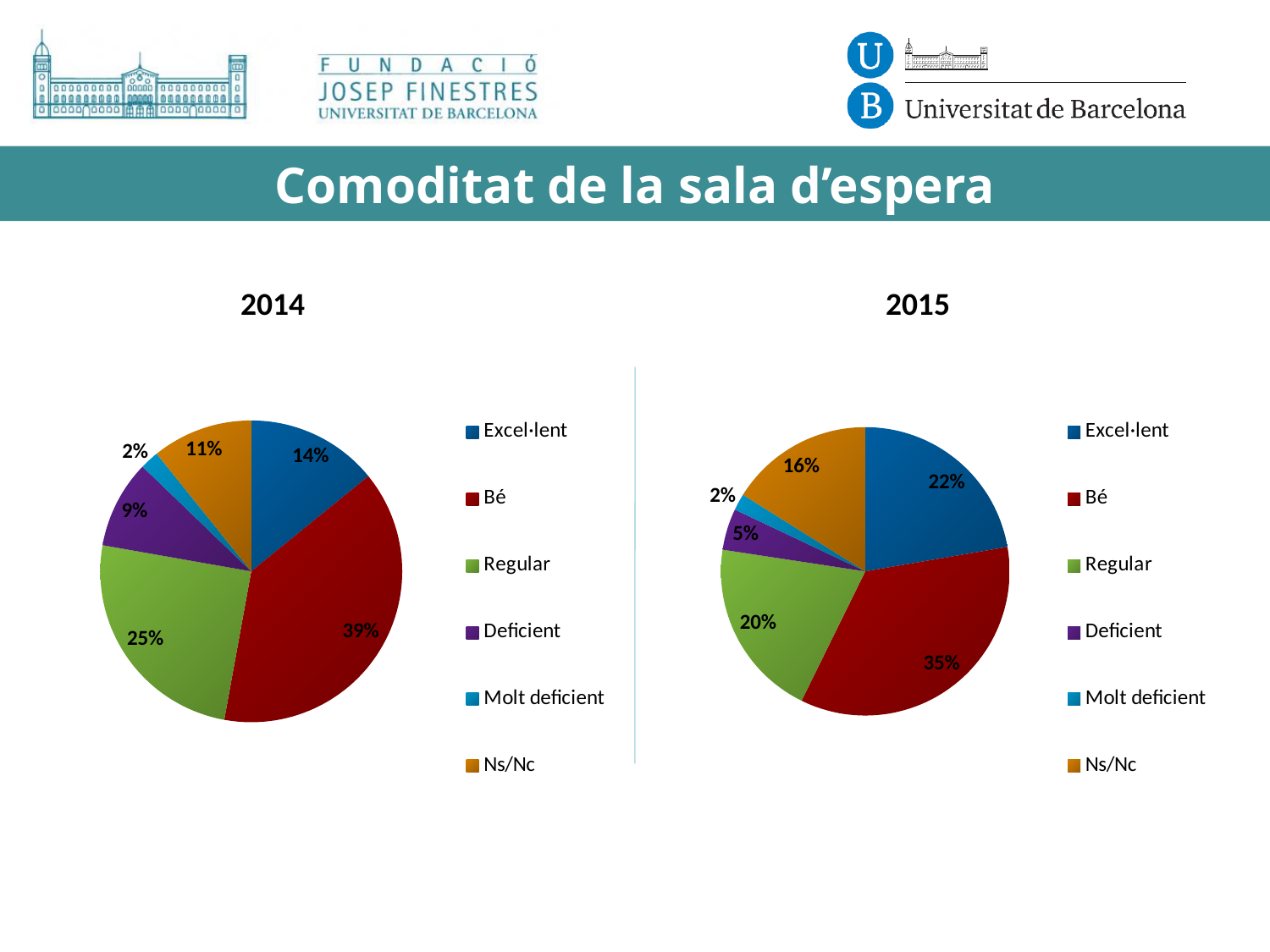
In the 2015 pie chart, which category has the smallest slice? Molt deficient In the 2014 pie chart, what colour is the Regular slice? Green In the 2015 pie chart, what share does Excel·lent have? 22% In the 2014 pie chart, which category has the largest slice? Bé In the 2015 pie chart, what is the difference between the Bé and Regular shares? 15% What type of chart is used for the 2014 data? Pie chart In the 2015 pie chart, what share does Deficient have? 5% In the 2015 pie chart, what share does Ns/Nc have? 16% In the 2014 pie chart, what share does Bé have? 39% In the 2014 pie chart, what share does Regular have? 25% In the 2014 pie chart, which is larger: Deficient or Ns/Nc? Ns/Nc How many categories does the legend of the 2015 pie chart list? 6